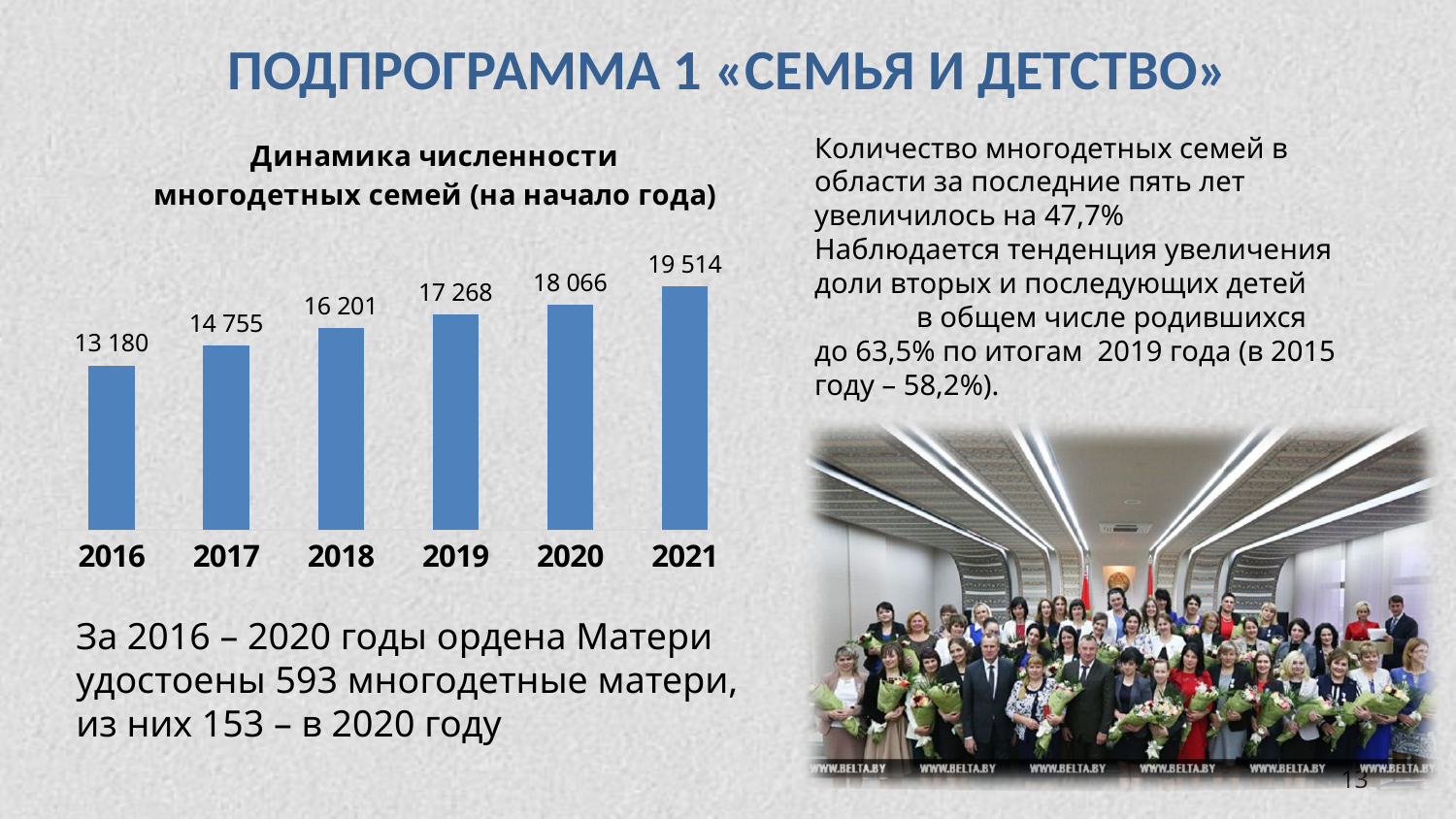
Which year has the lowest value? 2016 How many years are shown on the chart? 6 Do the values rise or fall from 2016 to 2021? Rise What is the value shown for 2021? 19 514 What kind of chart is shown? Bar chart What is the value shown for 2016? 13 180 What is the difference between the values for 2021 and 2016? 6 334 Which is larger, the value for 2018 or the value for 2020? 2020 What is the value shown for 2019? 17 268 Which year has the highest value? 2021 What is the title of the chart? Динамика численности многодетных семей (на начало года) What is the difference between the values for 2017 and 2016? 1 575